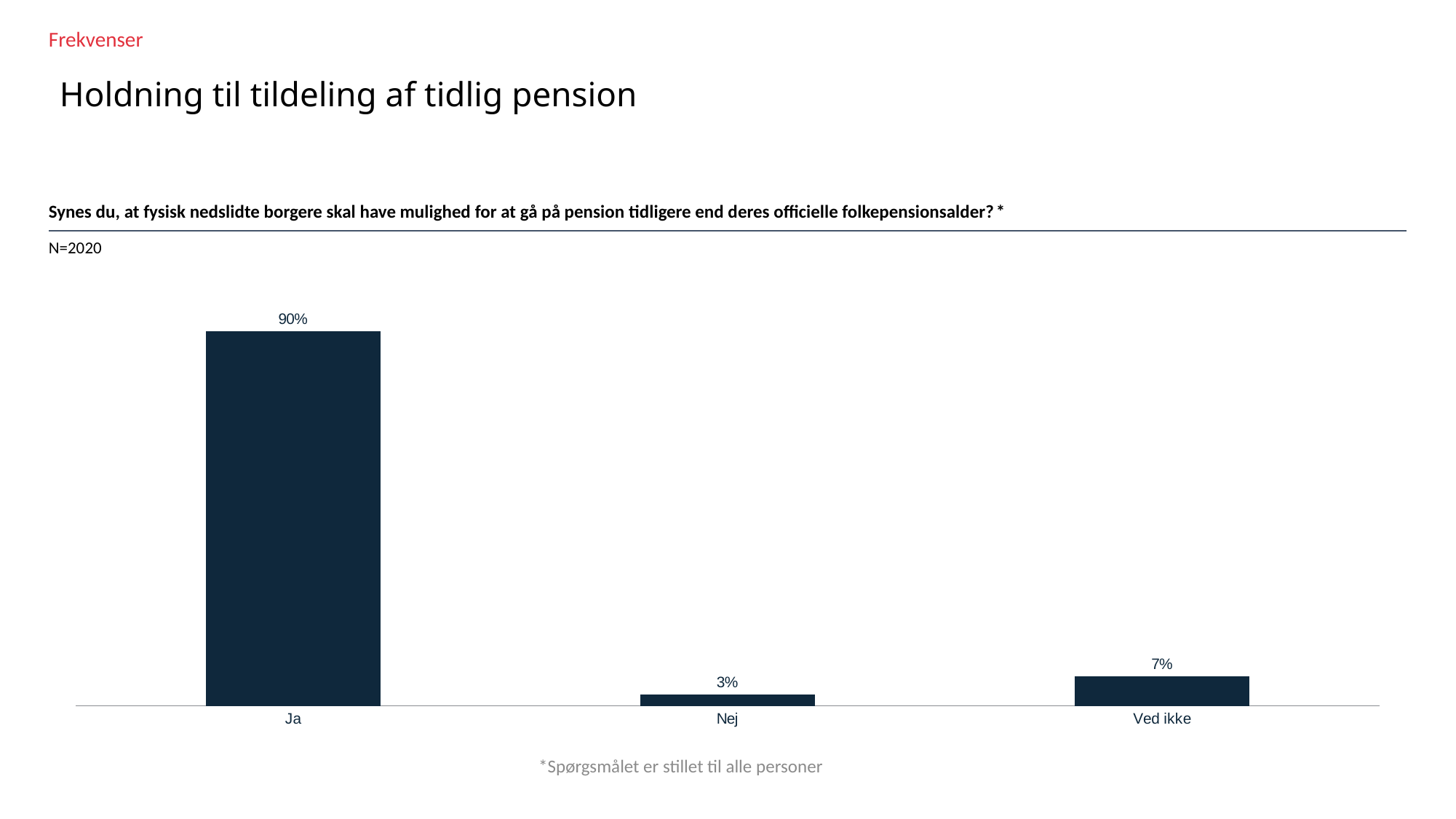
What is the value for Nej? 3% What is the difference between the values for Ja and Nej? 87% Which category has the highest value? Ja What is the value for Ja? 90% What is the title of the slide? Holdning til tildeling af tidlig pension What is the sample size (N) stated above the chart? N=2020 Which category has the lowest value? Nej Which is larger, the value for Nej or the value for Ved ikke? Ved ikke What kind of chart is shown on the slide? Bar chart What is the difference between the values for Ved ikke and Nej? 4% What is the value for Ved ikke? 7% How many categories are shown in the chart? 3